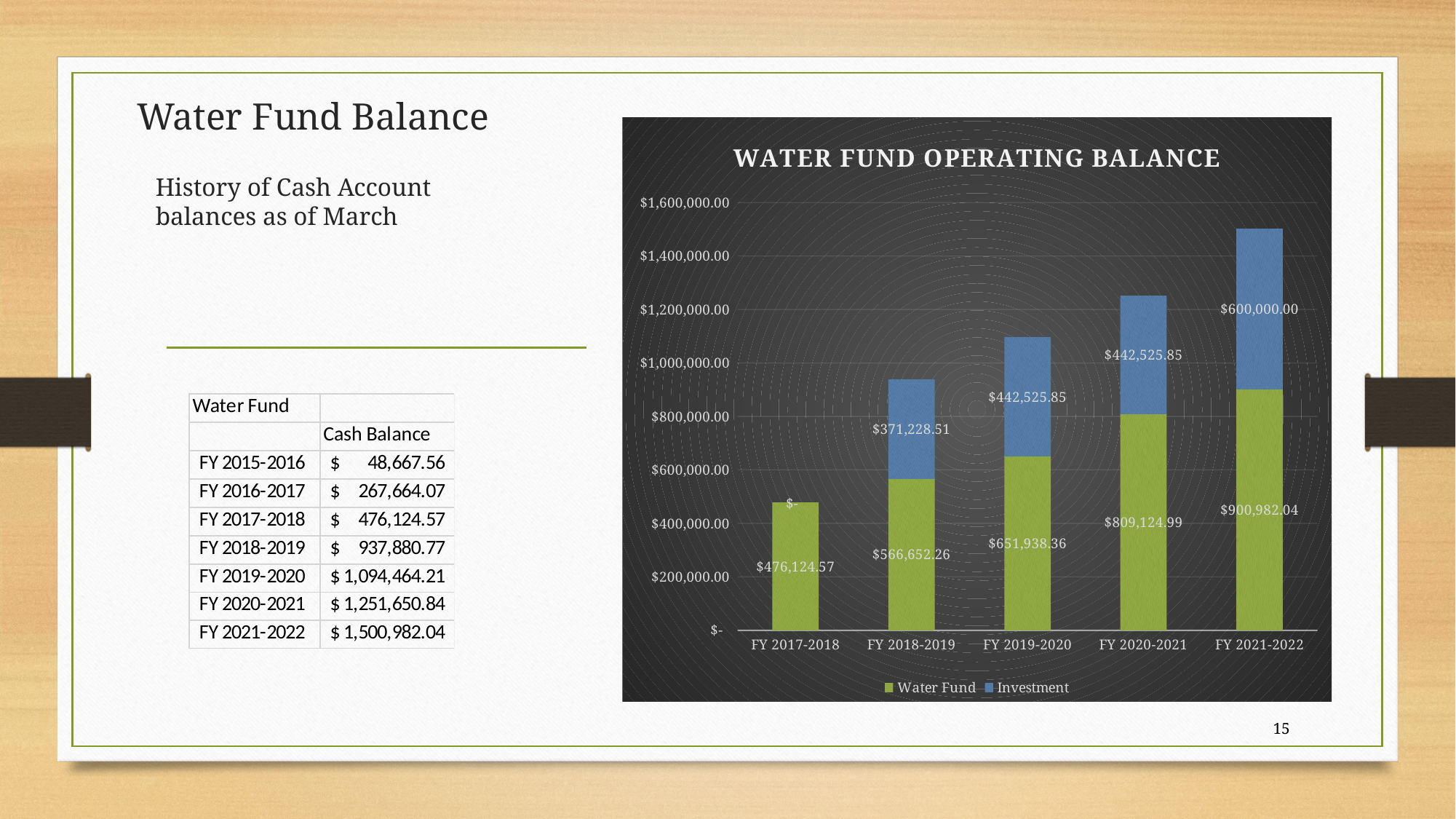
What is the total of the stacked bar for FY 2018-2019 in the chart? $937,880.77 What is the Investment value for FY 2021-2022 in the Water Fund Operating Balance chart? $600,000.00 How many series does the chart legend list? 2 What type of chart is shown on the slide? Stacked bar chart Do the Water Fund values rise or fall from FY 2017-2018 to FY 2021-2022? Rise What is the difference between the Water Fund values for FY 2021-2022 and FY 2020-2021? $91,857.05 Which is larger in the chart: the Investment value for FY 2019-2020 or the Investment value for FY 2021-2022? FY 2021-2022 What is the Water Fund value for FY 2019-2020 in the Water Fund Operating Balance chart? $651,938.36 Which fiscal year has the highest Water Fund value in the chart? FY 2021-2022 How many fiscal years are shown on the x axis of the chart? 5 Which fiscal year has the lowest Water Fund value in the chart? FY 2017-2018 What is the Investment value for FY 2018-2019 in the Water Fund Operating Balance chart? $371,228.51